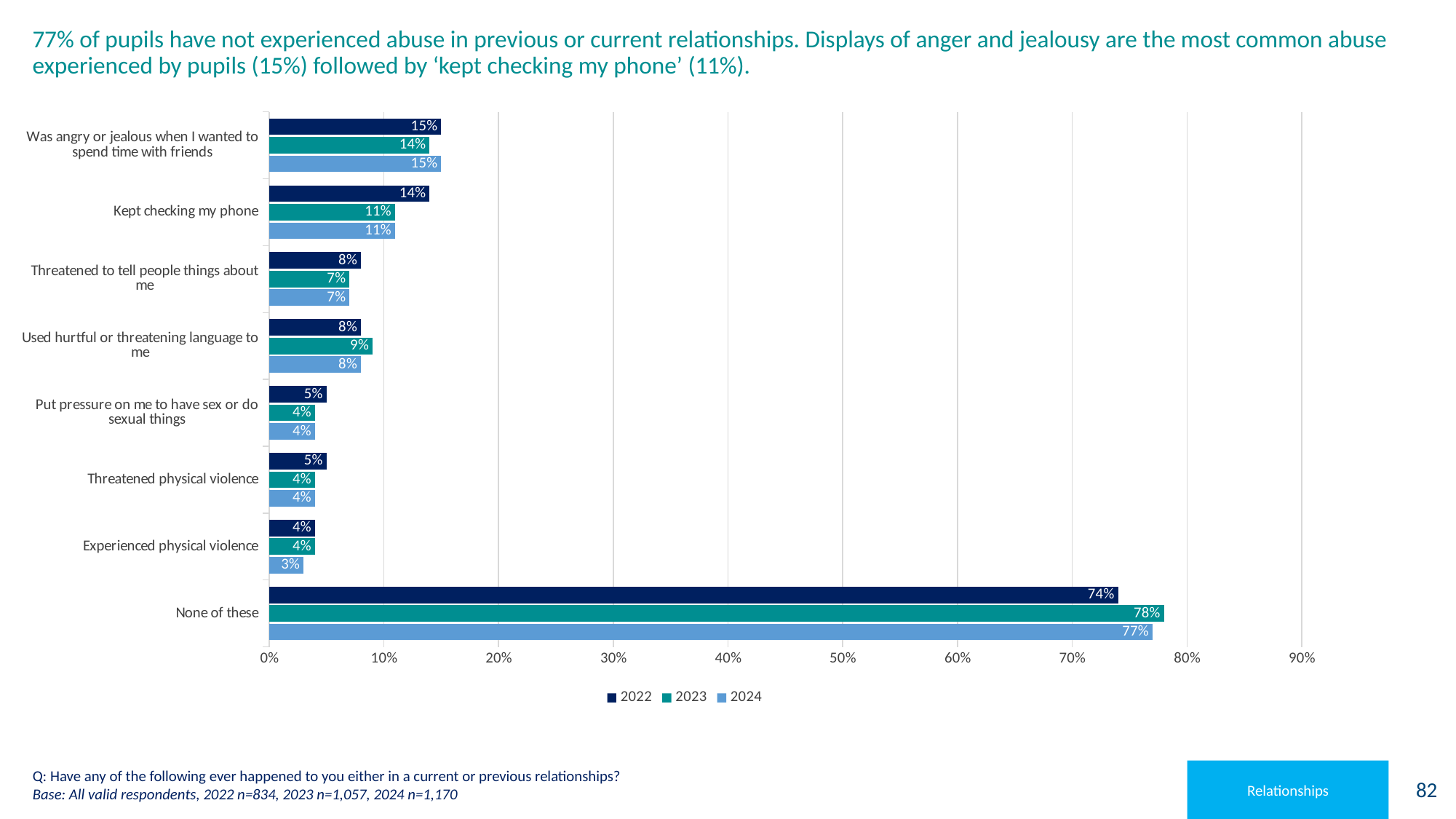
Excluding 'None of these', which category has the highest 2024 value? Was angry or jealous when I wanted to spend time with friends What is the 2024 value for 'Kept checking my phone'? 11% Is the 2024 value for 'None of these' greater or less than 70%? greater What is the difference between the 2023 and 2022 values for 'None of these'? 4% What is the 2022 value for 'None of these'? 74% What is the 2024 value for 'Experienced physical violence'? 3% Which category has the highest 2023 value? None of these How many series does the legend list? 3 What kind of chart is shown on the slide? Bar chart Which is larger for 'Threatened to tell people things about me': the 2022 value or the 2024 value? 2022 What is the 2023 value for 'Used hurtful or threatening language to me'? 9% What is the difference between the 2022 and 2023 values for 'Kept checking my phone'? 3%